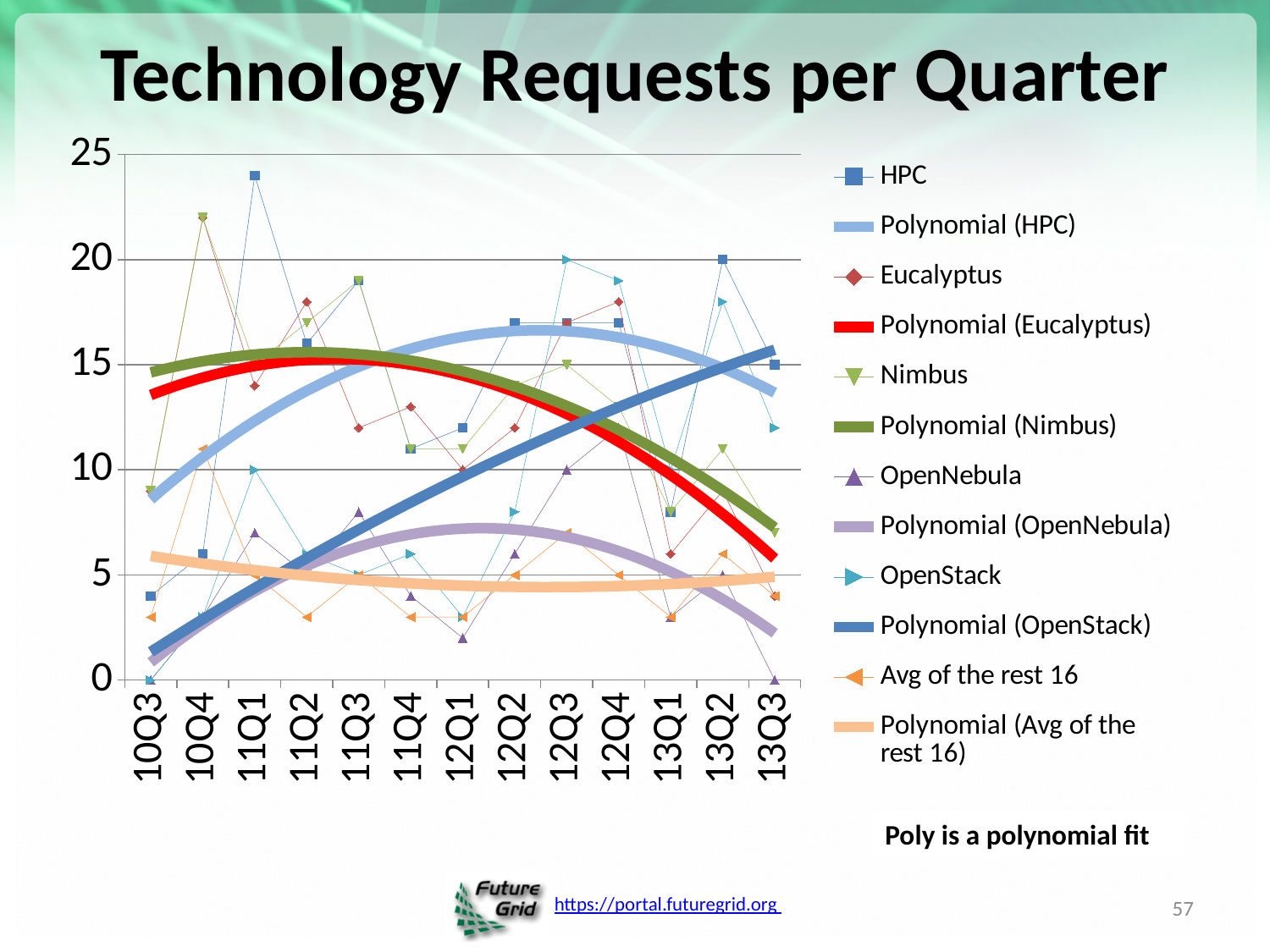
Is the HPC value at 11Q1 greater or less than 20? greater What is the title of the chart? Technology Requests per Quarter At 11Q1, which is larger: the HPC value or the Eucalyptus value? HPC Does the Polynomial (OpenStack) fit line rise or fall from 10Q3 to 13Q3? rise What type of chart is shown on the slide? line chart Is the OpenNebula value at 12Q1 greater or less than 5? less What is the HPC value at 13Q2? 20 In which quarter does HPC reach its highest value? 11Q1 How many entries does the legend list? 12 How many quarters are shown along the x axis? 13 What is the OpenStack value at 10Q3? 0 What is the OpenStack value at 12Q3? 20